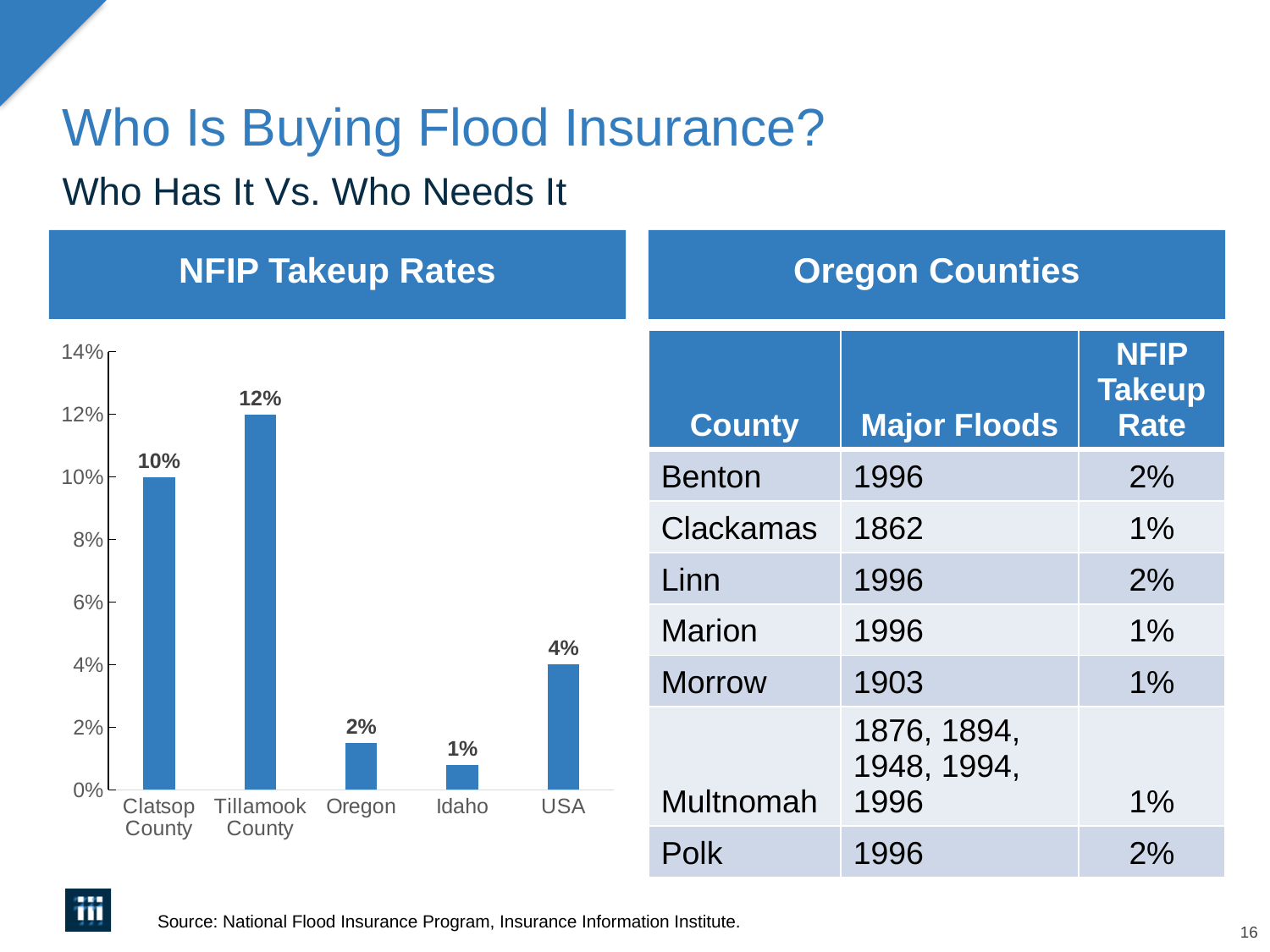
Which category has the lowest NFIP takeup rate in the chart? Idaho Which category has the highest NFIP takeup rate in the chart? Tillamook County What is the NFIP takeup rate shown for Idaho? 1% How many categories are shown in the NFIP Takeup Rates chart? 5 What kind of chart is the NFIP Takeup Rates chart? Bar chart What is the NFIP takeup rate shown for Clatsop County? 10% What is the NFIP takeup rate shown for the USA? 4% What is the difference between the NFIP takeup rates of Tillamook County and Clatsop County? 2% Which has a higher NFIP takeup rate, Oregon or the USA? USA Is the value for Tillamook County greater or less than 10%? greater What is the NFIP takeup rate shown for Tillamook County? 12% What is the title of the chart on the left of the slide? NFIP Takeup Rates